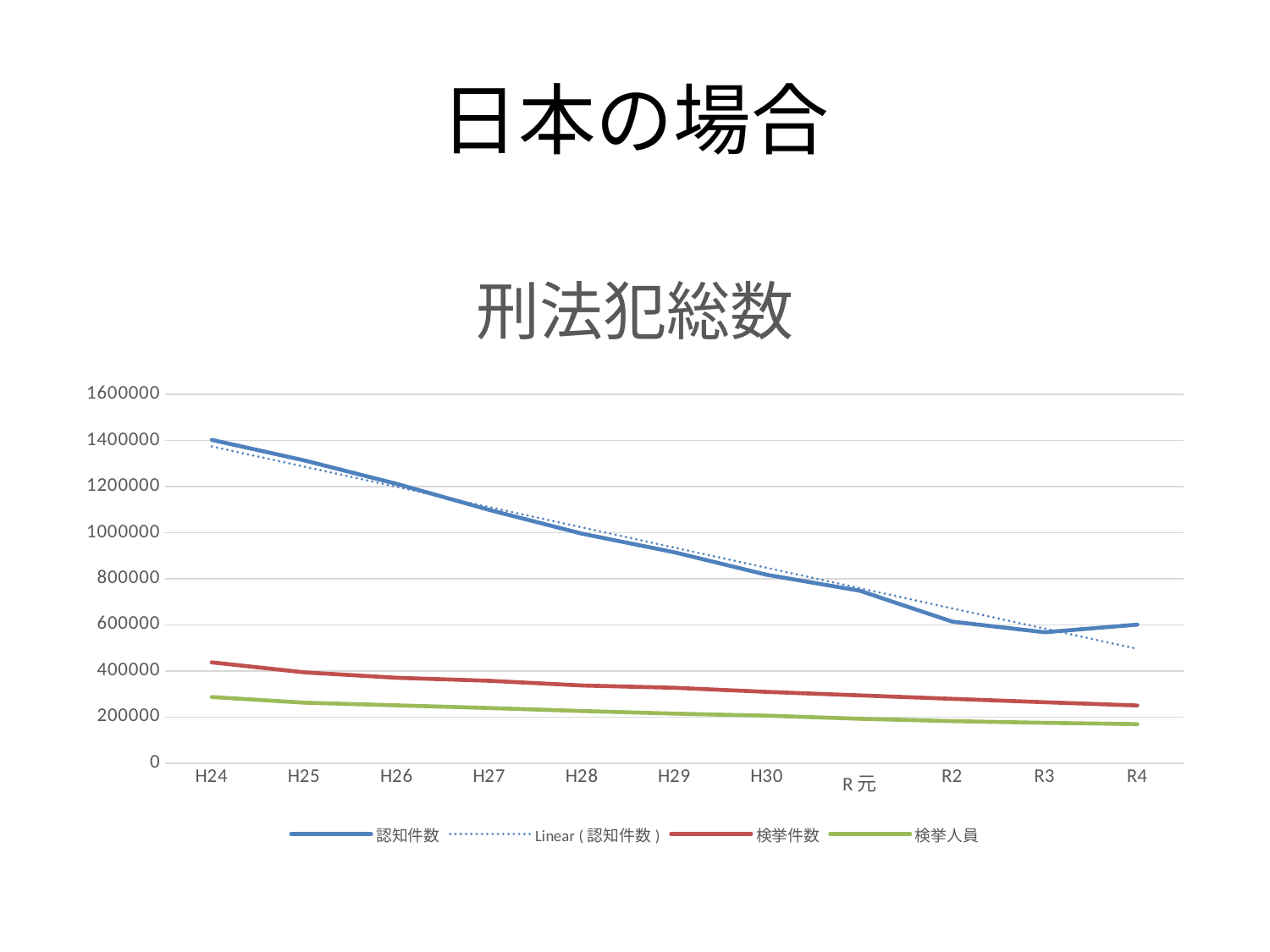
Does 認知件数 generally rise or fall from H24 to R4? fall Is the value of 認知件数 for H24 greater or less than 1200000? greater How many categories are shown on the x axis? 11 How many entries does the chart legend list? 4 Is the value of 検挙人員 for R4 greater or less than 200000? less Is the value of 検挙件数 for R4 greater or less than 200000? greater In which year is 認知件数 lowest? R3 At H24, which is larger: 検挙件数 or 検挙人員? 検挙件数 What is the title of the chart? 刑法犯総数 In which year is 認知件数 highest? H24 What kind of chart is shown on the slide? Line chart